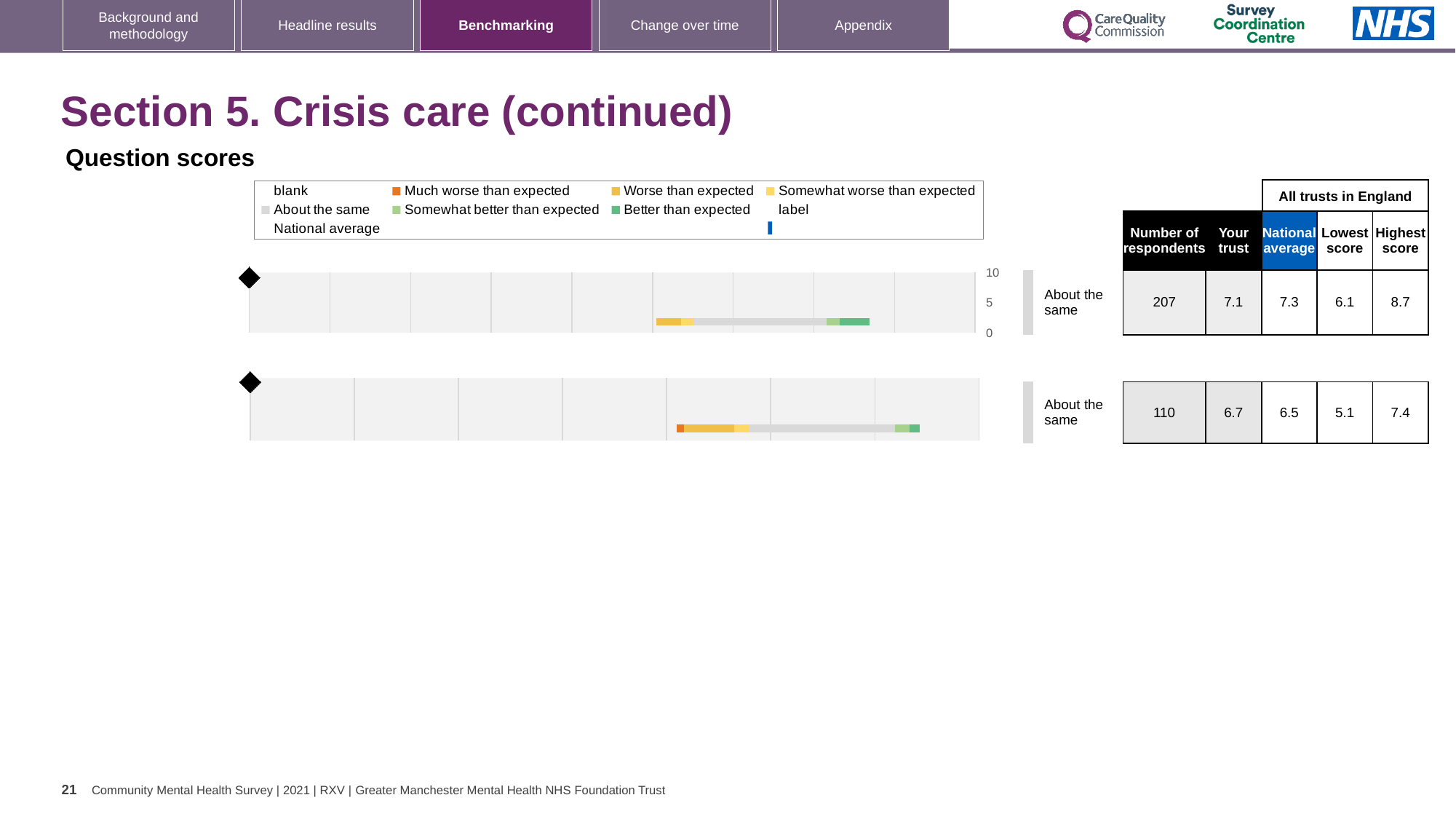
What benchmark category is shown next to both charts? About the same How many question score charts are shown on the slide? 2 For the top chart, what is the number of respondents shown in the table? 207 For the bottom chart, what is the difference between the highest score and the lowest score? 2.3 For the top chart, what is the 'Your trust' score? 7.1 What kind of chart is used for the question scores on this slide? bar chart For the bottom chart, what is the lowest score among all trusts in England? 5.1 For the bottom chart, what is the number of respondents? 110 For the top chart, which is larger: the 'Your trust' score or the national average? National average For the top chart, what is the national average score? 7.3 For the top chart, what is the difference between the highest score and the lowest score? 2.6 For the bottom chart, what is the highest score among all trusts in England? 7.4